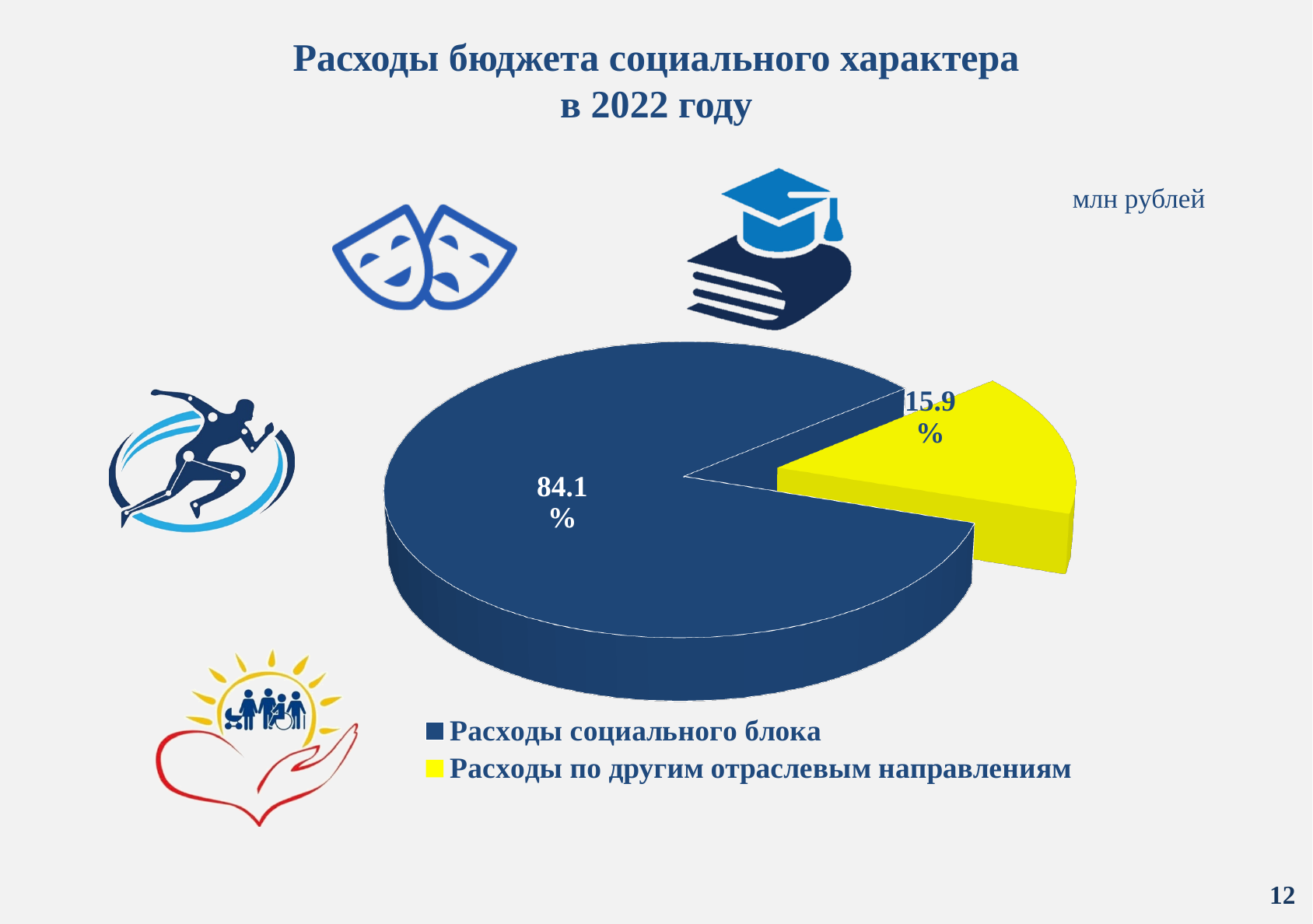
How many entries does the legend list? 2 What share of the pie does "Расходы по другим отраслевым направлениям" take? 15.9% What is the difference in percentage points between "Расходы социального блока" and "Расходы по другим отраслевым направлениям"? 68.2 Which is larger: "Расходы социального блока" or "Расходы по другим отраслевым направлениям"? Расходы социального блока What colour is the slice for "Расходы по другим отраслевым направлениям"? yellow Which slice of the pie is the smallest? Расходы по другим отраслевым направлениям What is the title of the chart on the slide? Расходы бюджета социального характера в 2022 году Which slice of the pie is the largest? Расходы социального блока What kind of chart is shown on the slide? pie chart How many slices does the pie chart have? 2 What share of the pie does "Расходы социального блока" take? 84.1%